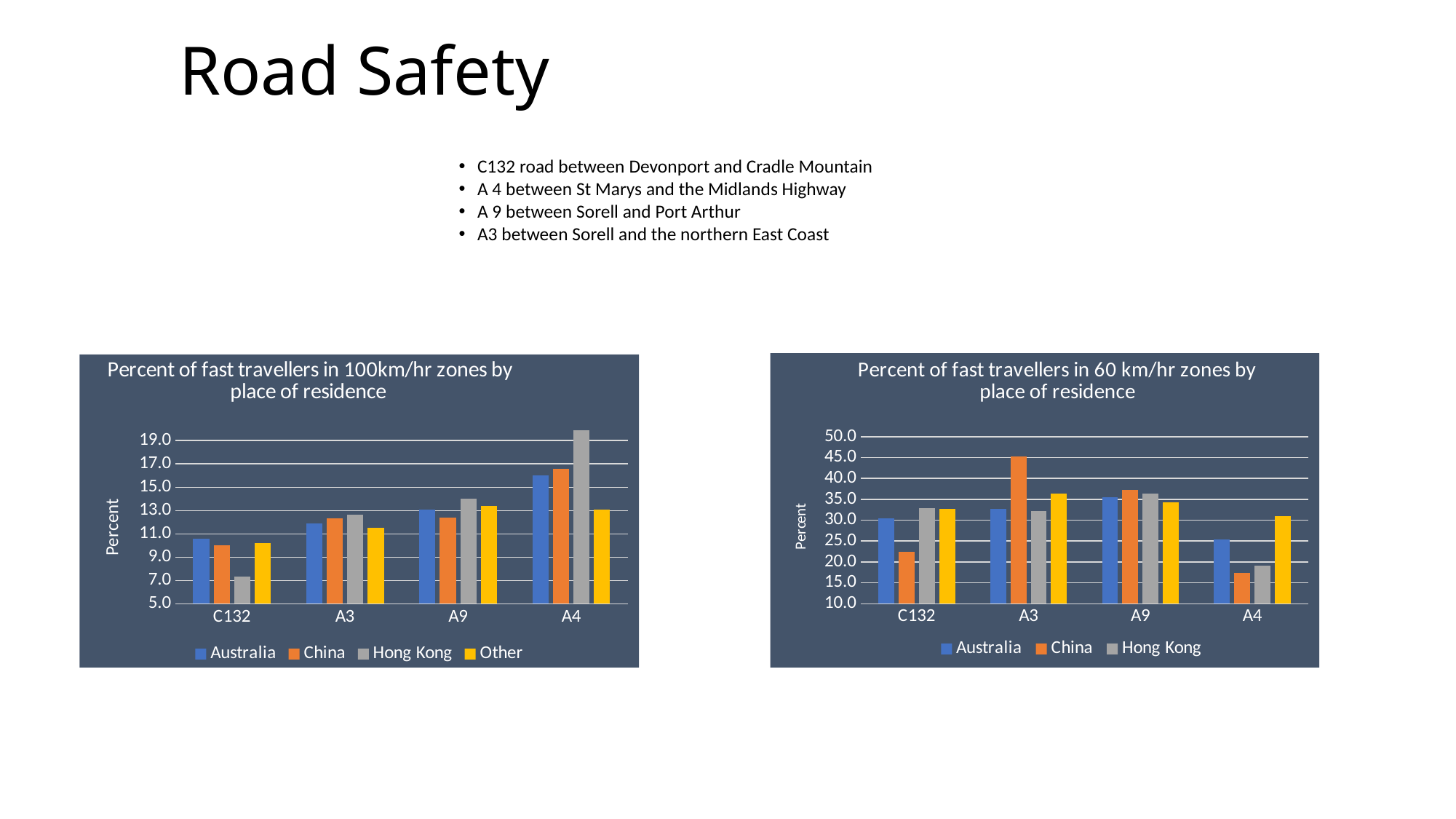
On the chart titled 'Percent of fast travellers in 60 km/hr zones by place of residence', which is larger at C132: Australia or China? Australia On the chart titled 'Percent of fast travellers in 60 km/hr zones by place of residence', which road has the lowest value for China? A4 On the chart titled 'Percent of fast travellers in 60 km/hr zones by place of residence', how many series does the legend list? 3 On the chart titled 'Percent of fast travellers in 100km/hr zones by place of residence', is the value for Hong Kong at C132 greater or less than 9.0? less On the chart titled 'Percent of fast travellers in 100km/hr zones by place of residence', which road has the lowest value for Hong Kong? C132 On the chart titled 'Percent of fast travellers in 100km/hr zones by place of residence', how many series does the legend list? 4 On the chart titled 'Percent of fast travellers in 100km/hr zones by place of residence', what kind of chart is shown? bar chart On the chart titled 'Percent of fast travellers in 100km/hr zones by place of residence', which road has the highest value for Hong Kong? A4 On the chart titled 'Percent of fast travellers in 100km/hr zones by place of residence', how many road categories are shown on the x axis? 4 On the chart titled 'Percent of fast travellers in 60 km/hr zones by place of residence', is the value for China at A3 greater or less than 40.0? greater On the chart titled 'Percent of fast travellers in 100km/hr zones by place of residence', is the value for Hong Kong at A4 greater or less than 19.0? greater On the chart titled 'Percent of fast travellers in 60 km/hr zones by place of residence', which road has the highest value for China? A3